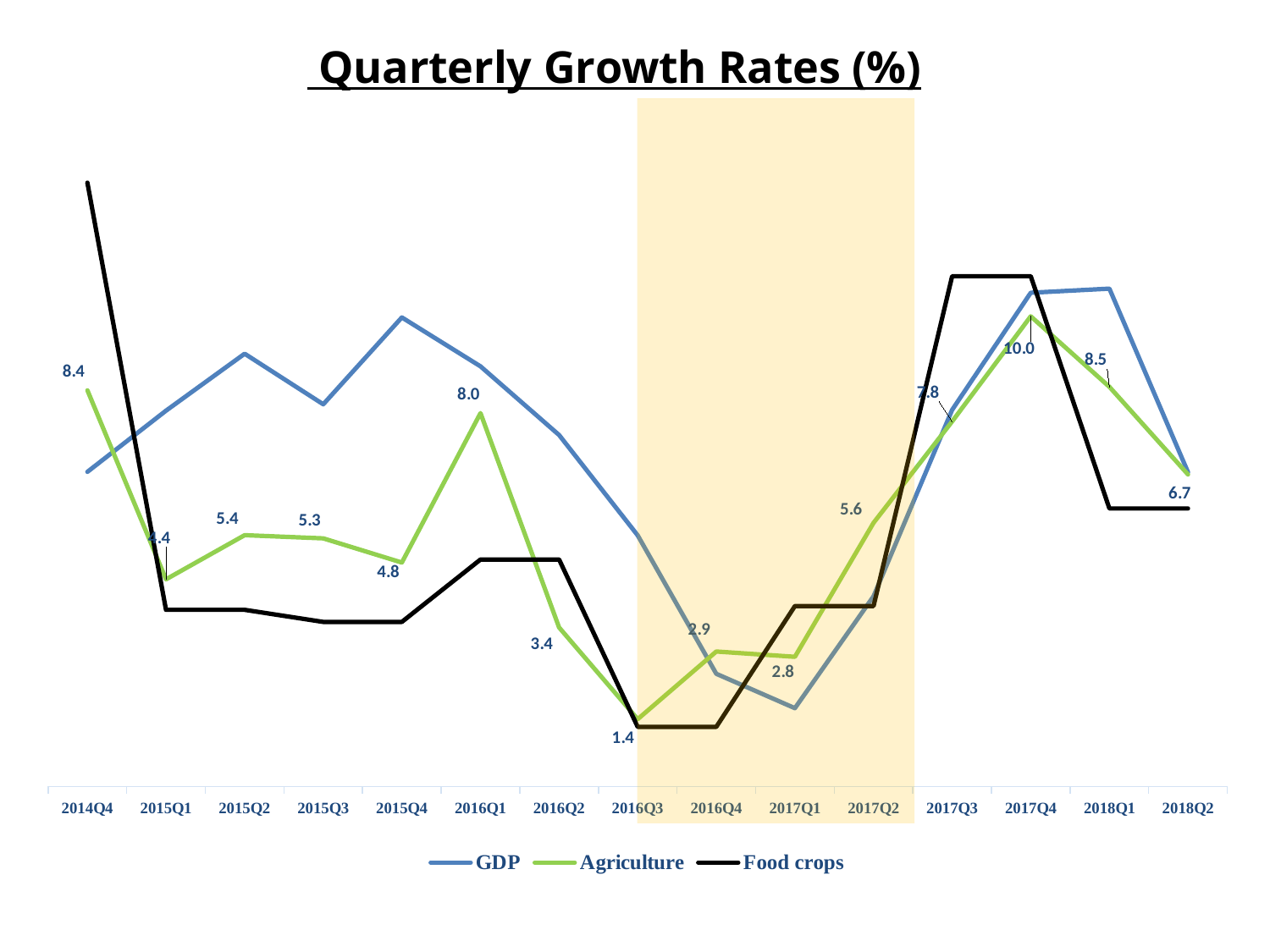
What is the Agriculture growth rate for 2016Q3? 1.4 What is the difference between the Agriculture growth rates in 2017Q4 and 2018Q1? 1.5 In which quarter does the Agriculture series reach its highest value? 2017Q4 How many series does the legend list? 3 What is the Agriculture growth rate for 2017Q4? 10.0 What kind of chart is shown on the slide? Line chart Which is larger, the Agriculture growth rate in 2016Q1 or in 2016Q2? 2016Q1 How many quarters are shown on the x axis? 15 Does the Agriculture series rise or fall from 2017Q4 to 2018Q2? Fall What is the Agriculture growth rate for 2014Q4? 8.4 What is the Agriculture growth rate for 2018Q2? 6.7 In which quarter does the Agriculture series reach its lowest value? 2016Q3